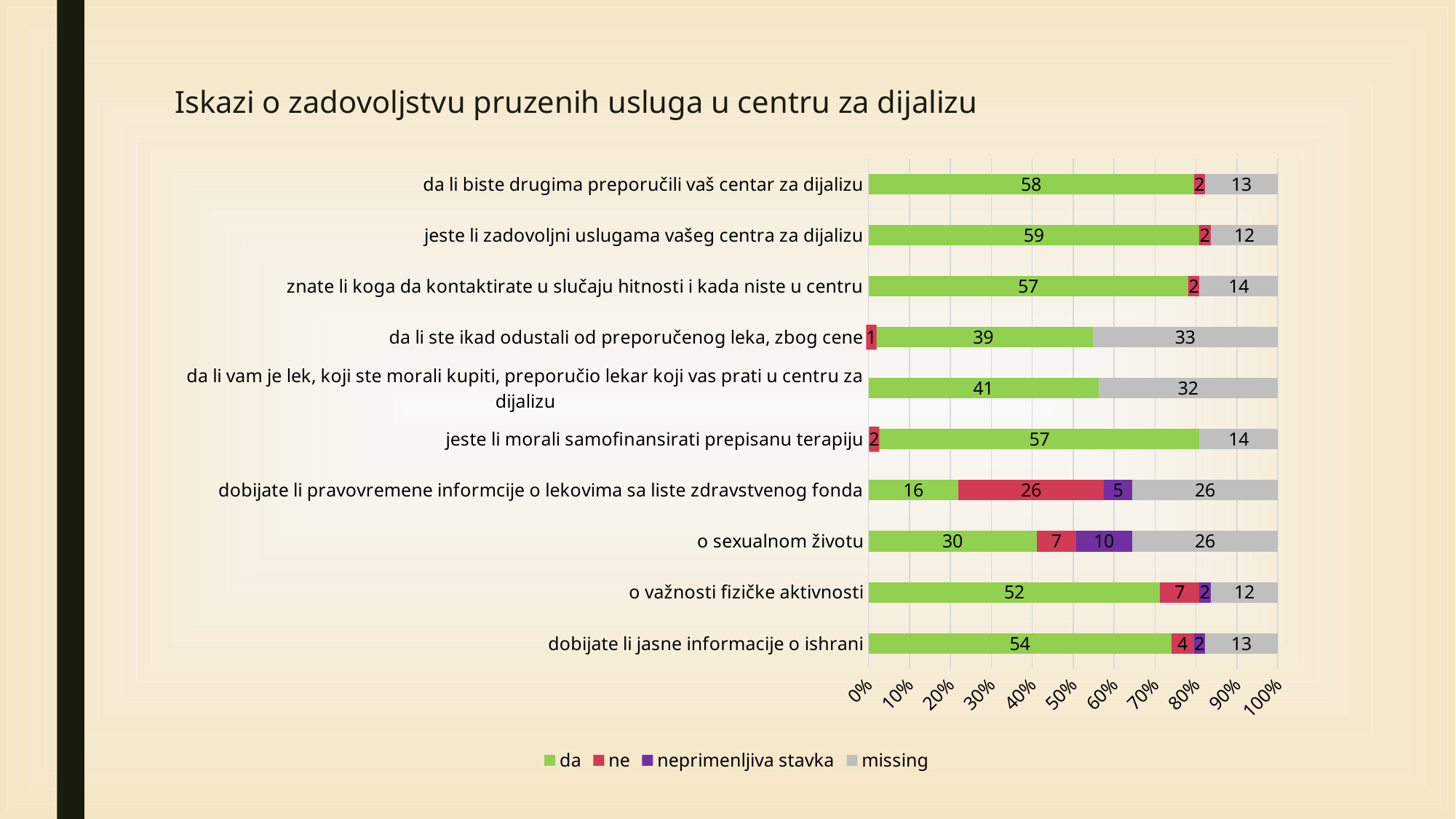
What is the total of all segments in the bar for 'o sexualnom životu'? 73 What colour represents the 'missing' series in the legend? Grey For 'o važnosti fizičke aktivnosti', what is the difference between the 'da' value and the 'ne' value? 45 Which category has the highest 'da' value? jeste li zadovoljni uslugama vašeg centra za dijalizu What type of chart is shown on the slide? Stacked bar chart Which has the larger 'missing' value: 'da li vam je lek, koji ste morali kupiti, preporučio lekar koji vas prati u centru za dijalizu' or 'dobijate li jasne informacije o ishrani'? da li vam je lek, koji ste morali kupiti, preporučio lekar koji vas prati u centru za dijalizu How many series does the legend list? 4 What is the 'missing' value for 'da li ste ikad odustali od preporučenog leka, zbog cene'? 33 What is the 'da' value for 'jeste li zadovoljni uslugama vašeg centra za dijalizu'? 59 What is the 'ne' value for 'dobijate li pravovremene informcije o lekovima sa liste zdravstvenog fonda'? 26 How many question categories are plotted on the chart? 10 What is the 'neprimenljiva stavka' value for 'o sexualnom životu'? 10